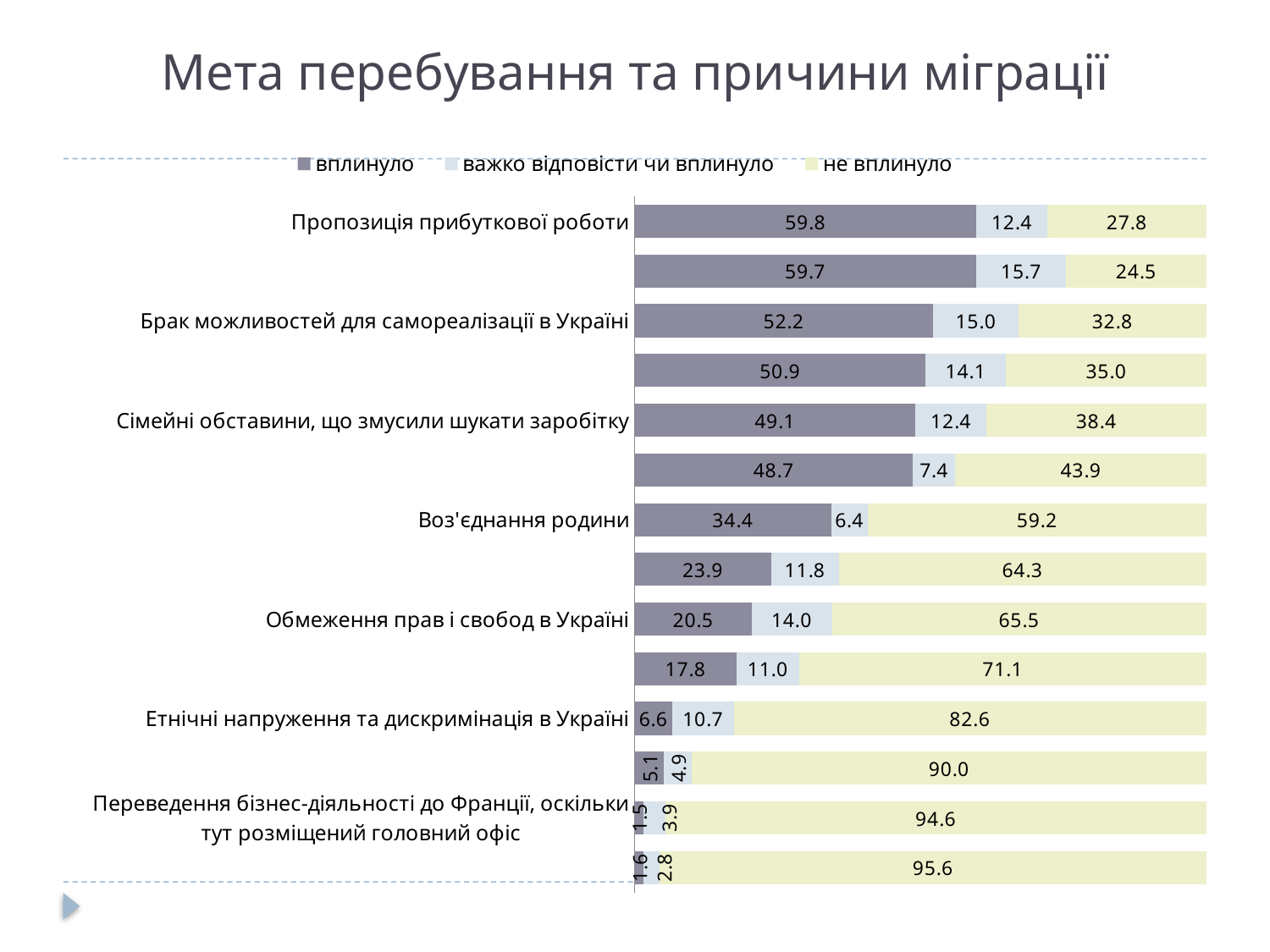
What is the value of the 'не вплинуло' series for 'Воз'єднання родини'? 59.2 Among the labeled categories, which has the lowest 'вплинуло' value? Переведення бізнес-діяльності до Франції, оскільки тут розміщений головний офіс What is the total of the stacked bar for 'Пропозиція прибуткової роботи'? 100.0 What is the difference between the 'не вплинуло' values for 'Етнічні напруження та дискримінація в Україні' and 'Сімейні обставини, що змусили шукати заробітку'? 44.2 What is the value of the 'вплинуло' series for 'Етнічні напруження та дискримінація в Україні'? 6.6 What is the value of the 'вплинуло' series for 'Пропозиція прибуткової роботи'? 59.8 Which has a larger 'вплинуло' value: 'Брак можливостей для самореалізації в Україні' or 'Сімейні обставини, що змусили шукати заробітку'? Брак можливостей для самореалізації в Україні What kind of chart is shown on the slide? Stacked bar chart Among the labeled categories, which has the highest 'вплинуло' value? Пропозиція прибуткової роботи What is the title of the slide? Мета перебування та причини міграції What is the value of the 'важко відповісти чи вплинуло' series for 'Обмеження прав і свобод в Україні'? 14.0 How many series does the legend list? 3